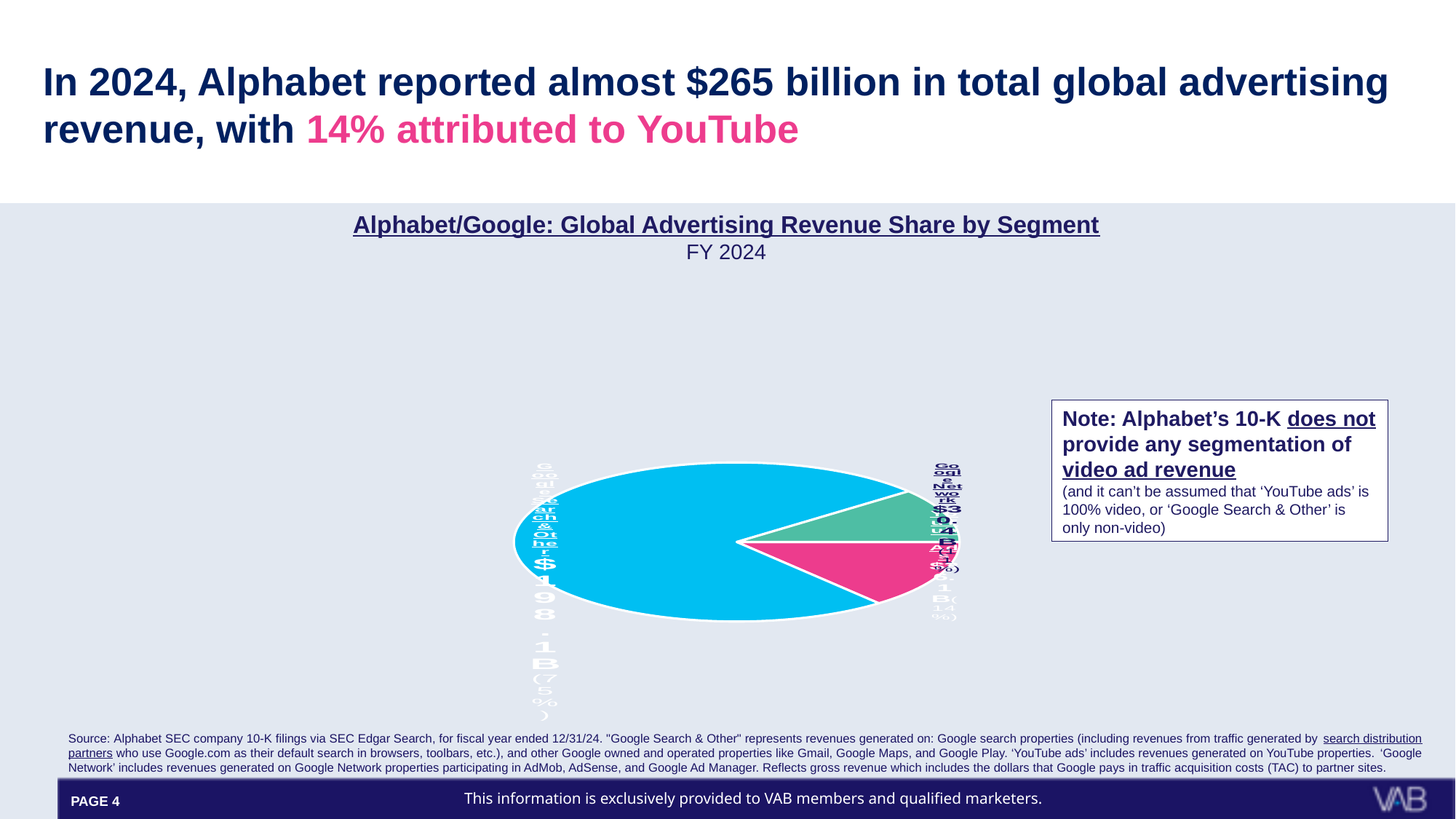
What is the title of the chart? Alphabet/Google: Global Advertising Revenue Share by Segment What kind of chart is shown on the slide? Pie chart Which segment has the largest share of Alphabet's global advertising revenue in the pie chart? Google Search & Other What share of global advertising revenue is attributed to YouTube ads? 14% What is the revenue value shown for the Google Network segment? $30.4B What is the revenue value shown for the Google Search & Other segment? $198.1B Which is larger: the Google Search & Other slice or the YouTube ads slice? Google Search & Other Which fiscal year does the chart cover? FY 2024 How many segments (slices) does the pie chart have? 3 What share of global advertising revenue does the Google Search & Other slice represent? 75%